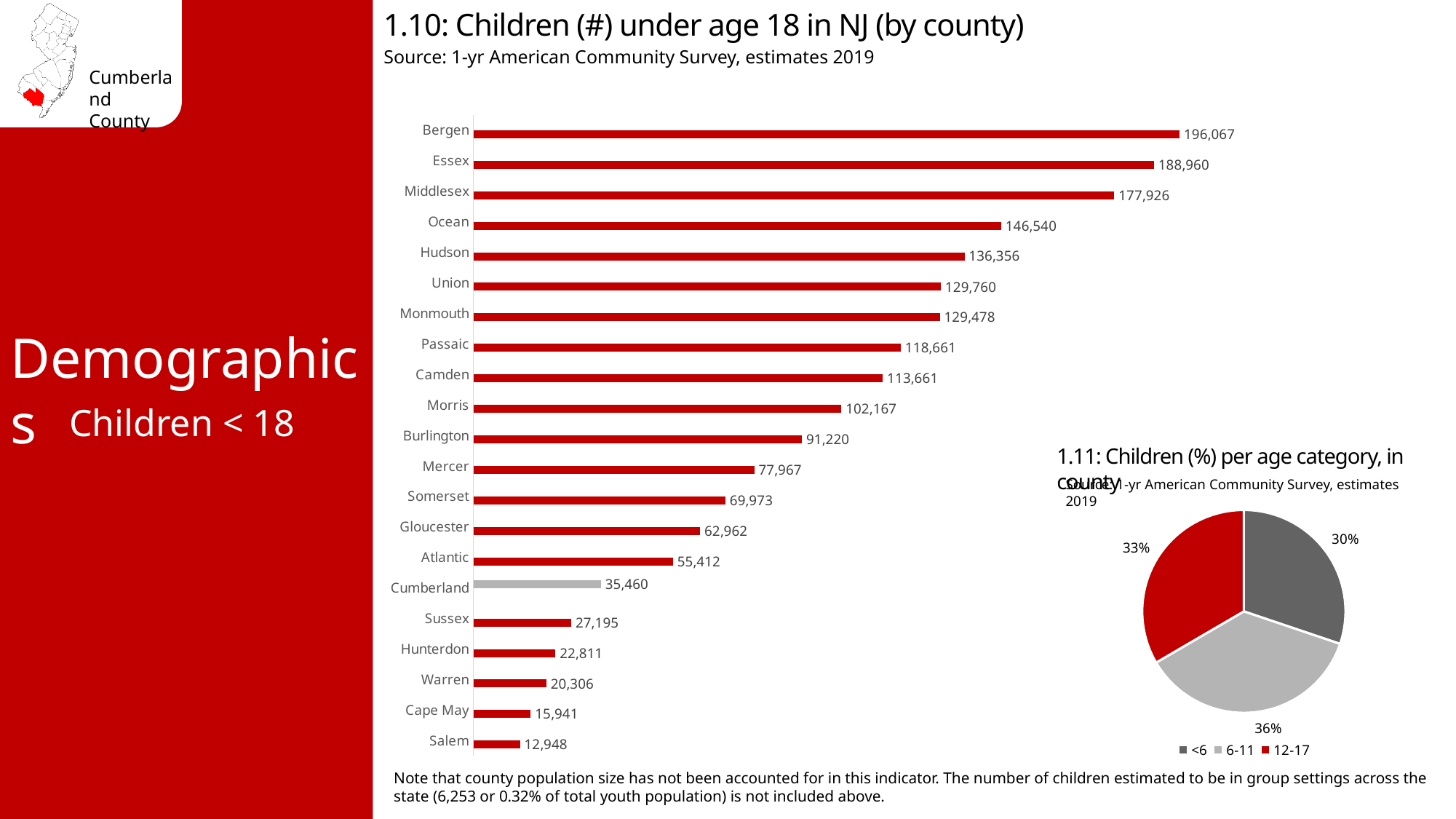
In the pie chart '1.11: Children (%) per age category, in county', what share of children are aged 6-11? 36% What type of chart is '1.10: Children (#) under age 18 in NJ (by county)'? Bar chart In the chart '1.10: Children (#) under age 18 in NJ (by county)', how many counties are shown? 21 In the chart '1.10: Children (#) under age 18 in NJ (by county)', what is the value for Ocean? 146,540 In the chart '1.10: Children (#) under age 18 in NJ (by county)', which county has the lowest number of children under 18? Salem How many categories does the legend of the pie chart '1.11: Children (%) per age category, in county' list? 3 In the chart '1.10: Children (#) under age 18 in NJ (by county)', how many children under 18 are in Cumberland County? 35,460 In the chart '1.10: Children (#) under age 18 in NJ (by county)', which county has the highest number of children under 18? Bergen In the chart '1.10: Children (#) under age 18 in NJ (by county)', what is the difference between Bergen and Essex? 7,107 In the chart '1.10: Children (#) under age 18 in NJ (by county)', what is the value for Cape May? 15,941 In the pie chart '1.11: Children (%) per age category, in county', which age category has the smallest share? <6 In the chart '1.10: Children (#) under age 18 in NJ (by county)', which has more children under 18, Camden or Passaic? Passaic